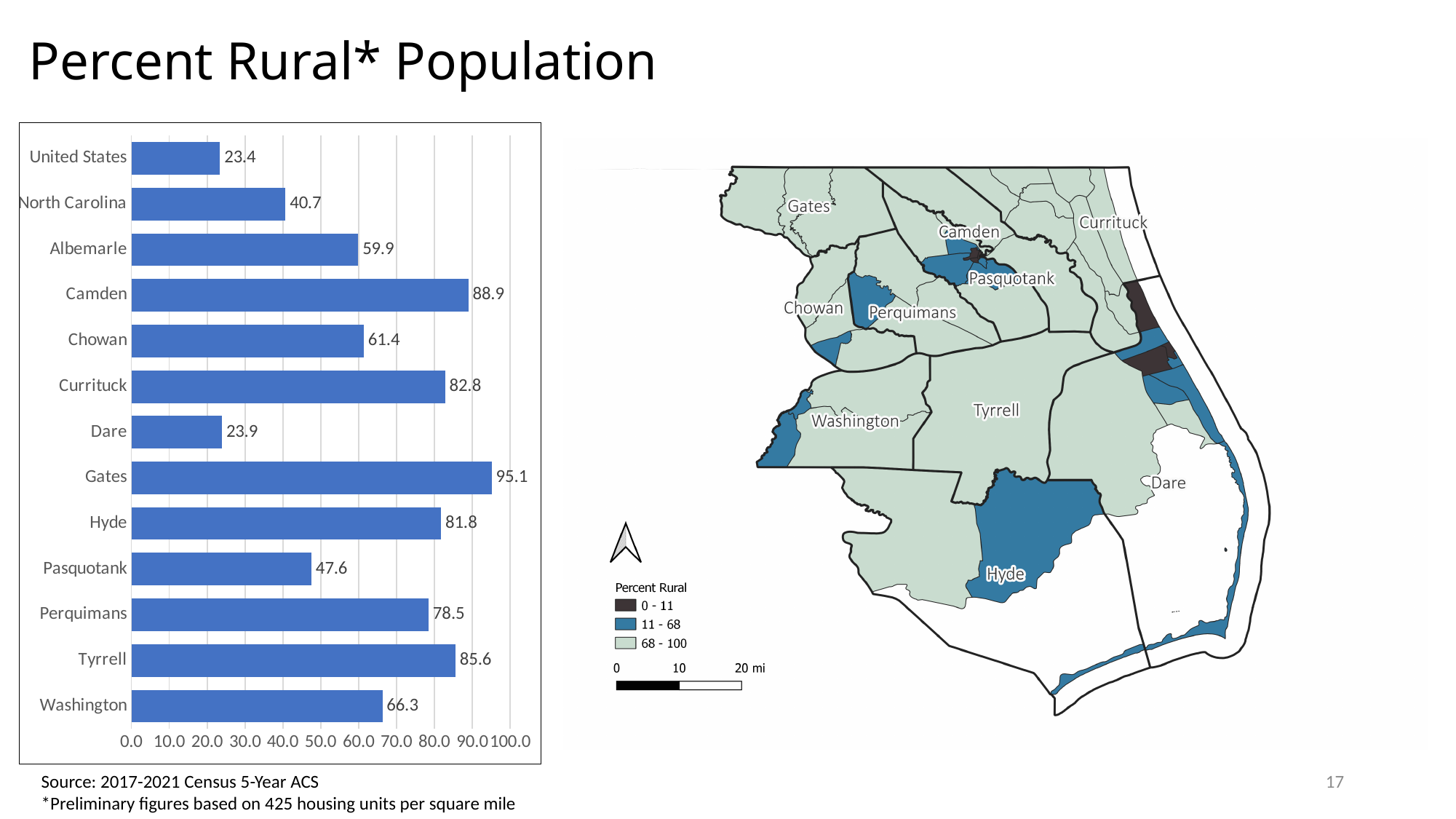
How many categories are shown in the bar chart? 13 What is the percent rural population for Camden in the bar chart? 88.9 What is the difference between the values for Tyrrell and Washington in the bar chart? 19.3 What value does the bar chart show for North Carolina? 40.7 Which category has the lowest value in the bar chart? United States What kind of chart is shown on the left of the slide? bar chart In the bar chart, which has a larger value, Currituck or Hyde? Currituck In the bar chart, is the value for Perquimans greater or less than 70.0? greater How many classes does the map's Percent Rural legend list? 3 Which category has the highest value in the bar chart? Gates What is the difference between the values for Camden and Chowan in the bar chart? 27.5 What is the value for Pasquotank in the bar chart? 47.6